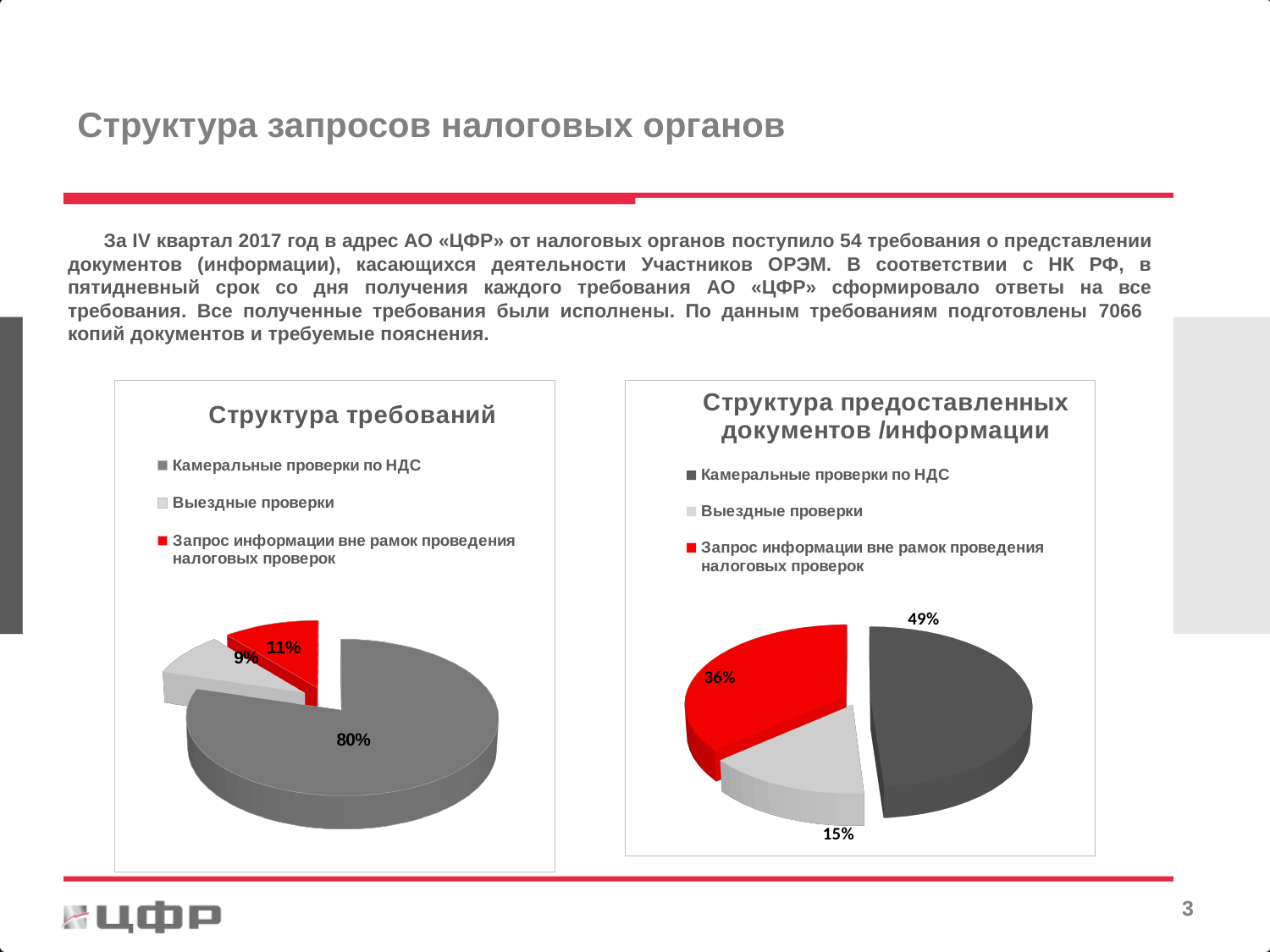
In the "Структура требований" chart, what share is shown for Выездные проверки? 9% In the "Структура требований" chart, which category has the smallest slice? Выездные проверки In the "Структура требований" chart, what share is shown for Запрос информации вне рамок проведения налоговых проверок? 11% In the "Структура предоставленных документов /информации" chart, which category has the largest slice? Камеральные проверки по НДС In the "Структура предоставленных документов /информации" chart, what is the difference in percentage points between Камеральные проверки по НДС and Запрос информации вне рамок проведения налоговых проверок? 13 percentage points What kind of chart is the "Структура требований" chart? pie chart In the "Структура требований" chart, how many slices does the pie have? 3 In the "Структура требований" chart, what share is shown for Камеральные проверки по НДС? 80% In the "Структура предоставленных документов /информации" chart, what share is shown for Запрос информации вне рамок проведения налоговых проверок? 36% In the "Структура предоставленных документов /информации" chart, what share is shown for Выездные проверки? 15% In the "Структура предоставленных документов /информации" chart, what share is shown for Камеральные проверки по НДС? 49% In the "Структура предоставленных документов /информации" chart, what colour is the slice for Запрос информации вне рамок проведения налоговых проверок? red